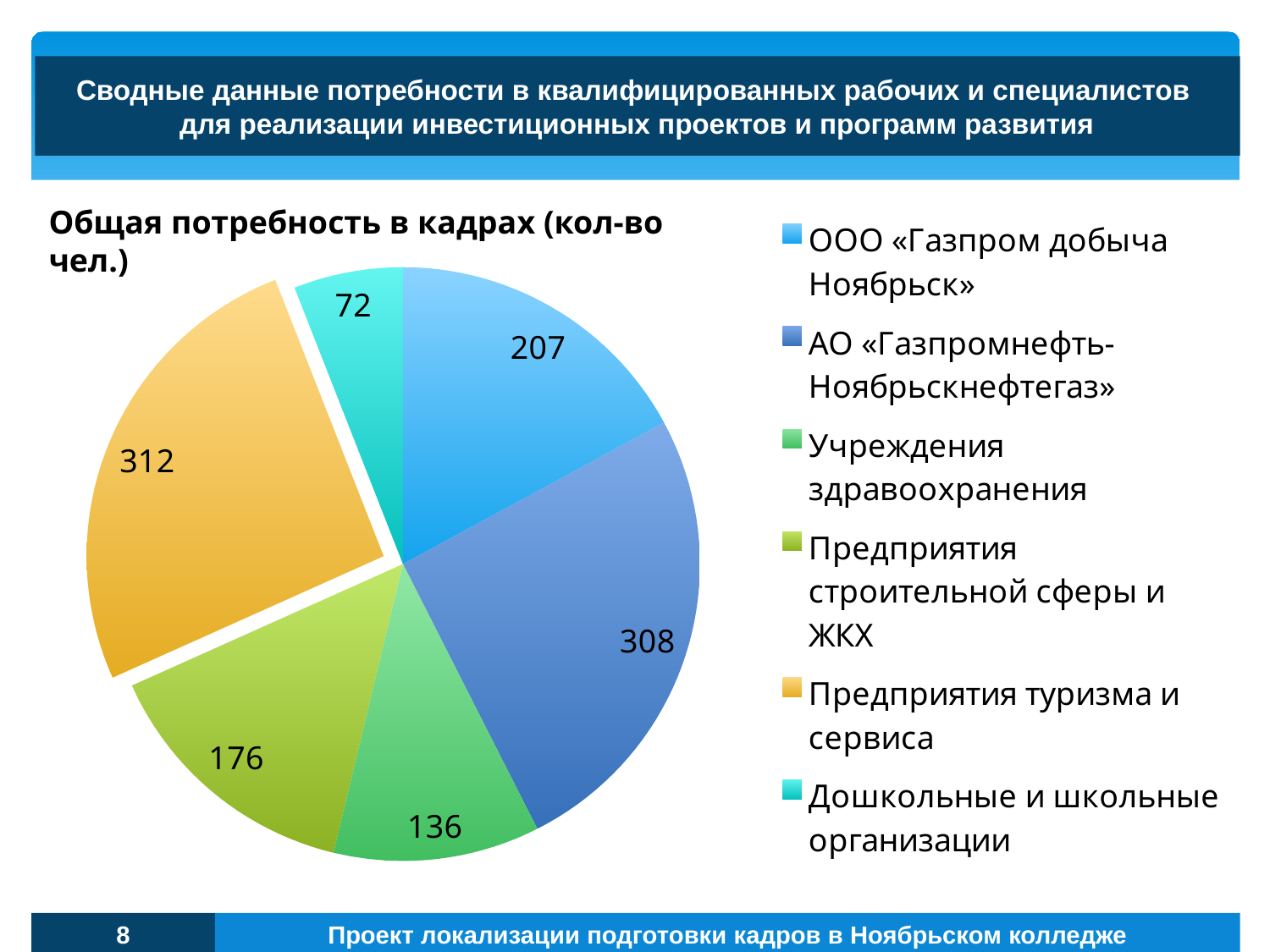
What type of chart is shown on the slide? pie chart How many categories does the pie chart have? 6 Which is larger: the value for Предприятия строительной сферы и ЖКХ or the value for Учреждения здравоохранения? Предприятия строительной сферы и ЖКХ What is the value for Предприятия строительной сферы и ЖКХ? 176 Which category has the highest value? Предприятия туризма и сервиса What is the value for ООО «Газпром добыча Ноябрьск»? 207 What is the difference between the values for Предприятия туризма и сервиса and АО «Газпромнефть-Ноябрьскнефтегаз»? 4 What is the value for АО «Газпромнефть-Ноябрьскнефтегаз»? 308 What is the value for Дошкольные и школьные организации? 72 What is the title of the chart? Общая потребность в кадрах (кол-во чел.) What is the value for Учреждения здравоохранения? 136 Which category has the lowest value? Дошкольные и школьные организации